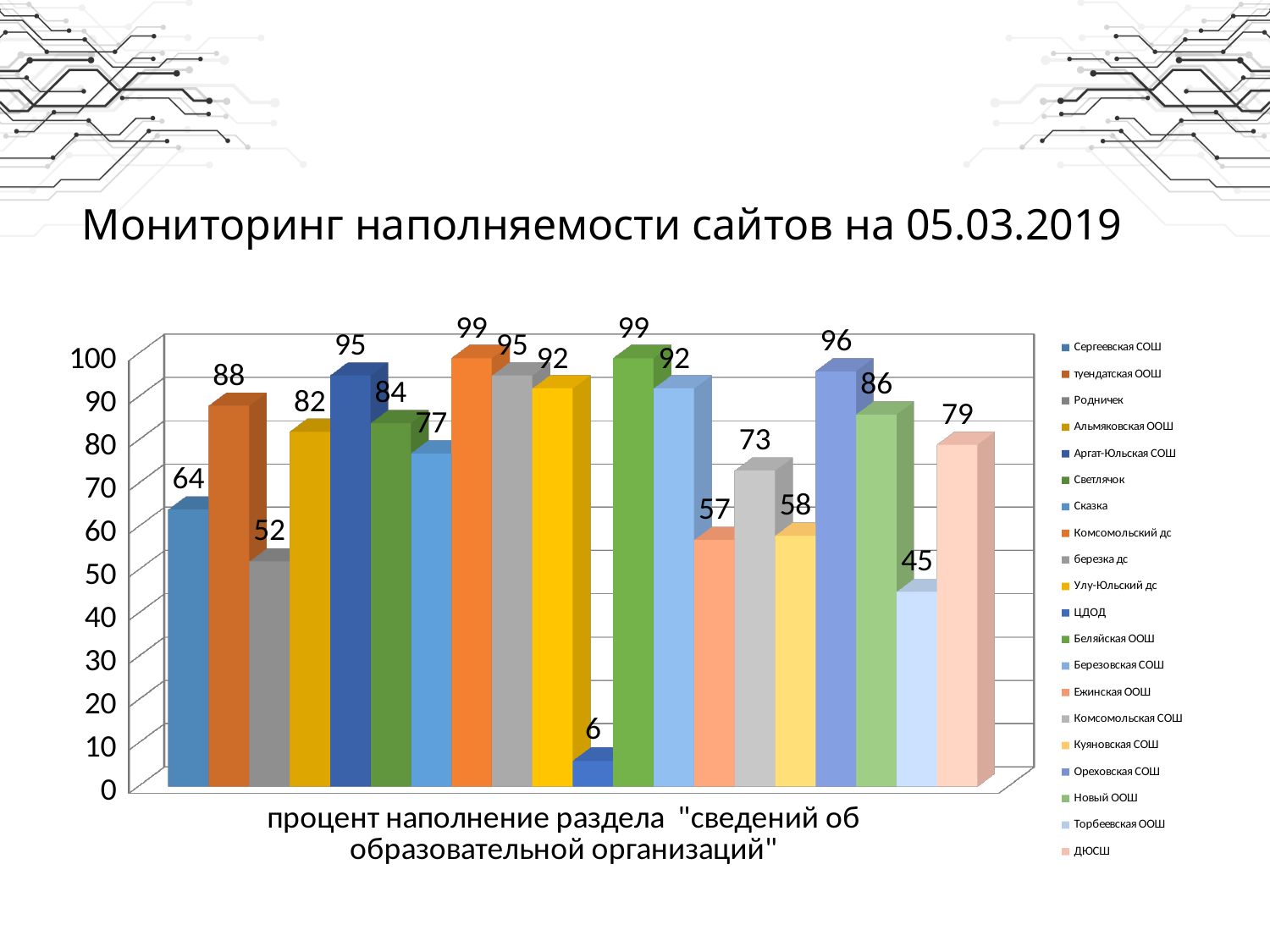
How many bars are plotted on the chart? 20 Which organisation has the lowest value? ЦДОД What is the title of the slide? Мониторинг наполняемости сайтов на 05.03.2019 What is the value for Торбеевская ООШ? 45 What is the value for ЦДОД? 6 What kind of chart is shown on the slide? Bar chart What is the value for Ореховская СОШ? 96 What is the highest value shown on the chart? 99 Which is larger, the value for Комсомольская СОШ or the value for Куяновская СОШ? Комсомольская СОШ How many entries does the legend list? 20 What is the difference between the values for туендатская ООШ and Родничек? 36 What is the value for Сергеевская СОШ? 64